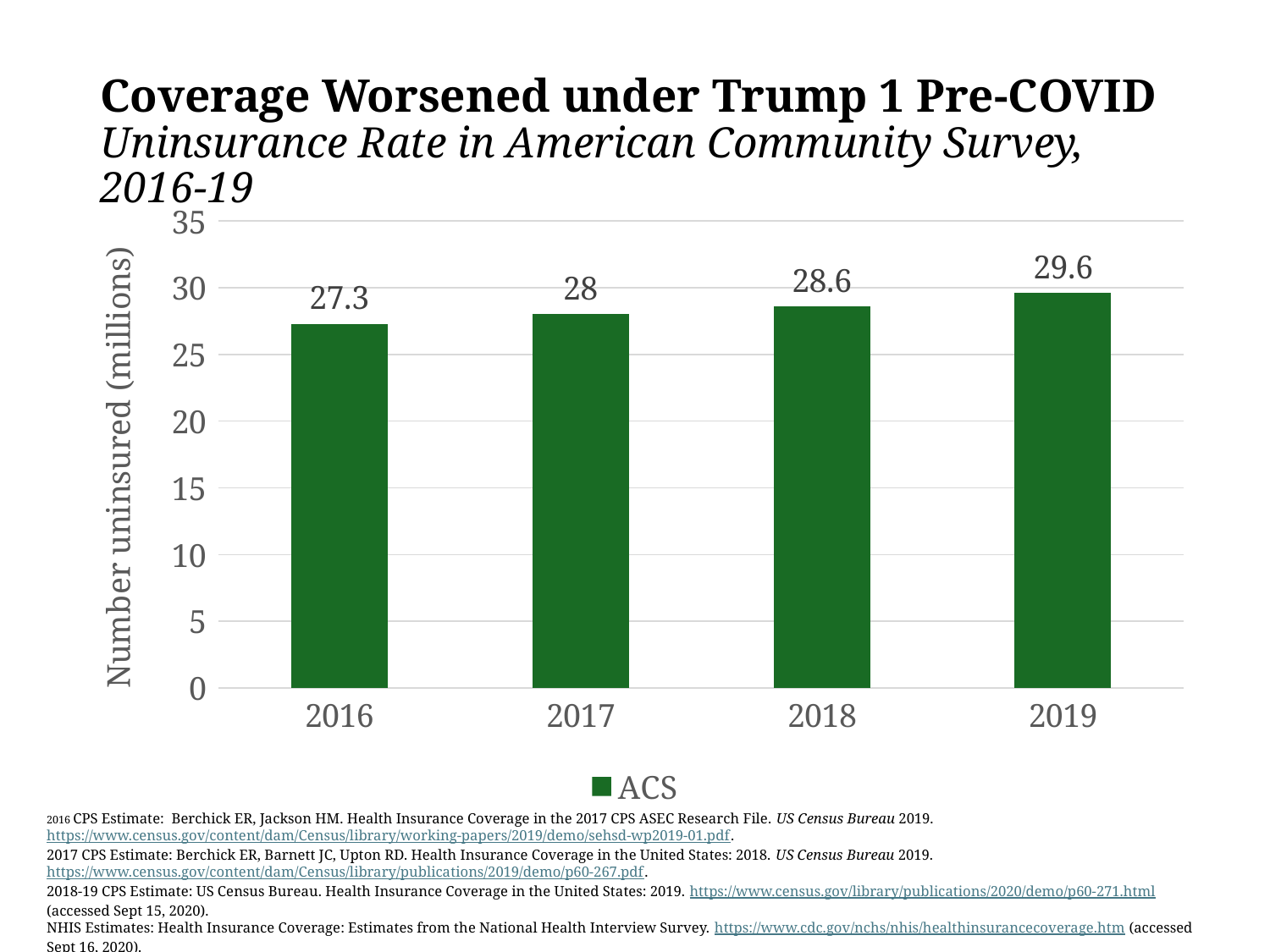
What is the number uninsured (millions) for 2016? 27.3 What is the number uninsured (millions) for 2019? 29.6 What is the value for 2017? 28 Which year has the highest number uninsured? 2019 What is the difference between the 2019 and 2016 values? 2.3 How many years are shown on the x axis? 4 Which is larger, the value for 2018 or the value for 2016? 2018 What is the difference between the 2018 and 2017 values? 0.6 What kind of chart is shown on the slide? bar chart Is the value for 2019 greater or less than 25? greater Which year has the lowest number uninsured? 2016 Do the values rise or fall from 2016 to 2019? rise